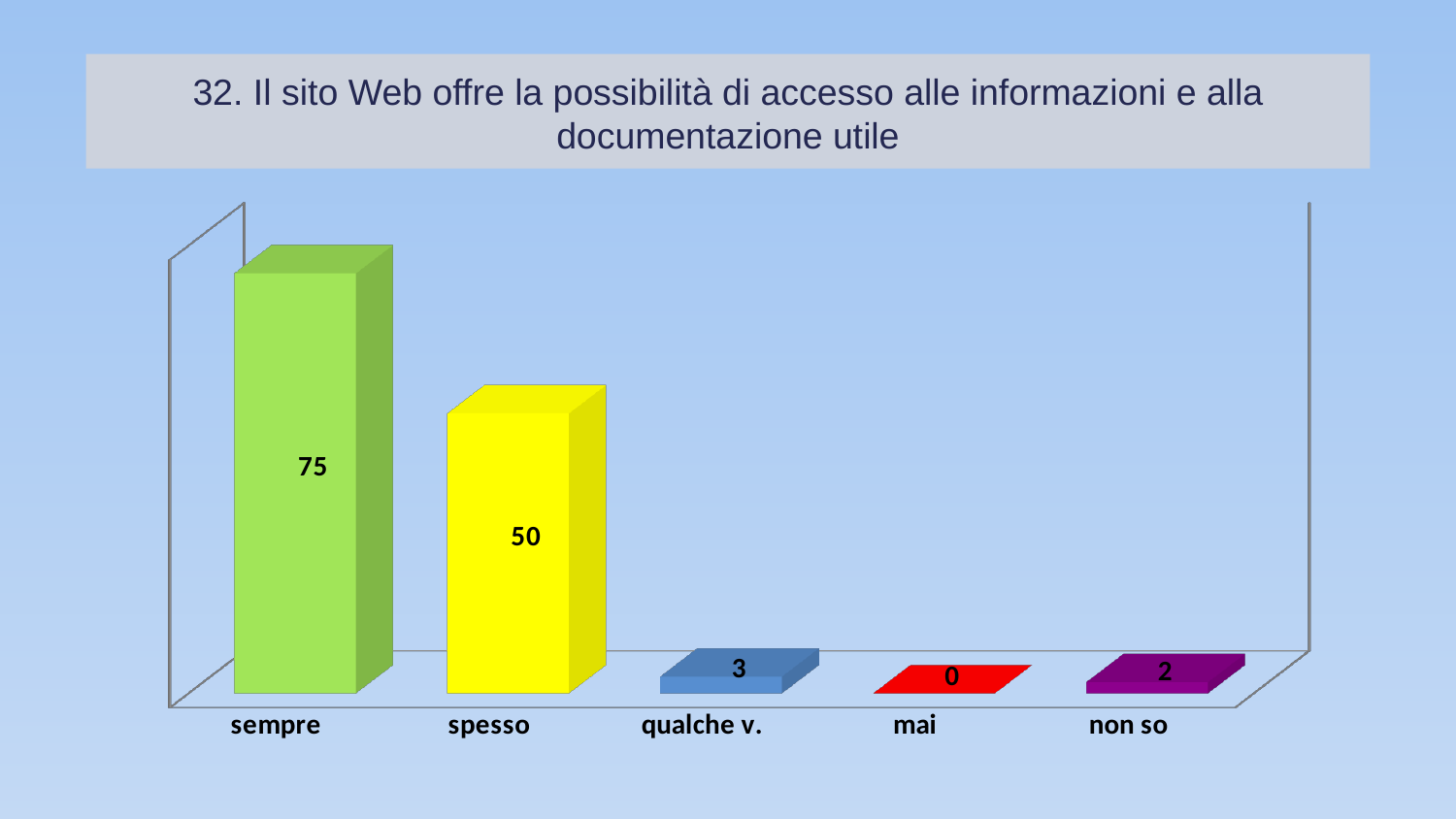
What is the value for "mai"? 0 Which category has the highest value? sempre What is the value for "qualche v."? 3 What is the value for "sempre"? 75 What is the value for "non so"? 2 Which is larger, the value for "qualche v." or the value for "non so"? qualche v. What is the difference between the values for "sempre" and "spesso"? 25 What kind of chart is shown on the slide? bar chart What is the title of the chart? 32. Il sito Web offre la possibilità di accesso alle informazioni e alla documentazione utile What is the value for "spesso"? 50 How many categories are shown on the x axis? 5 Which category has the lowest value? mai